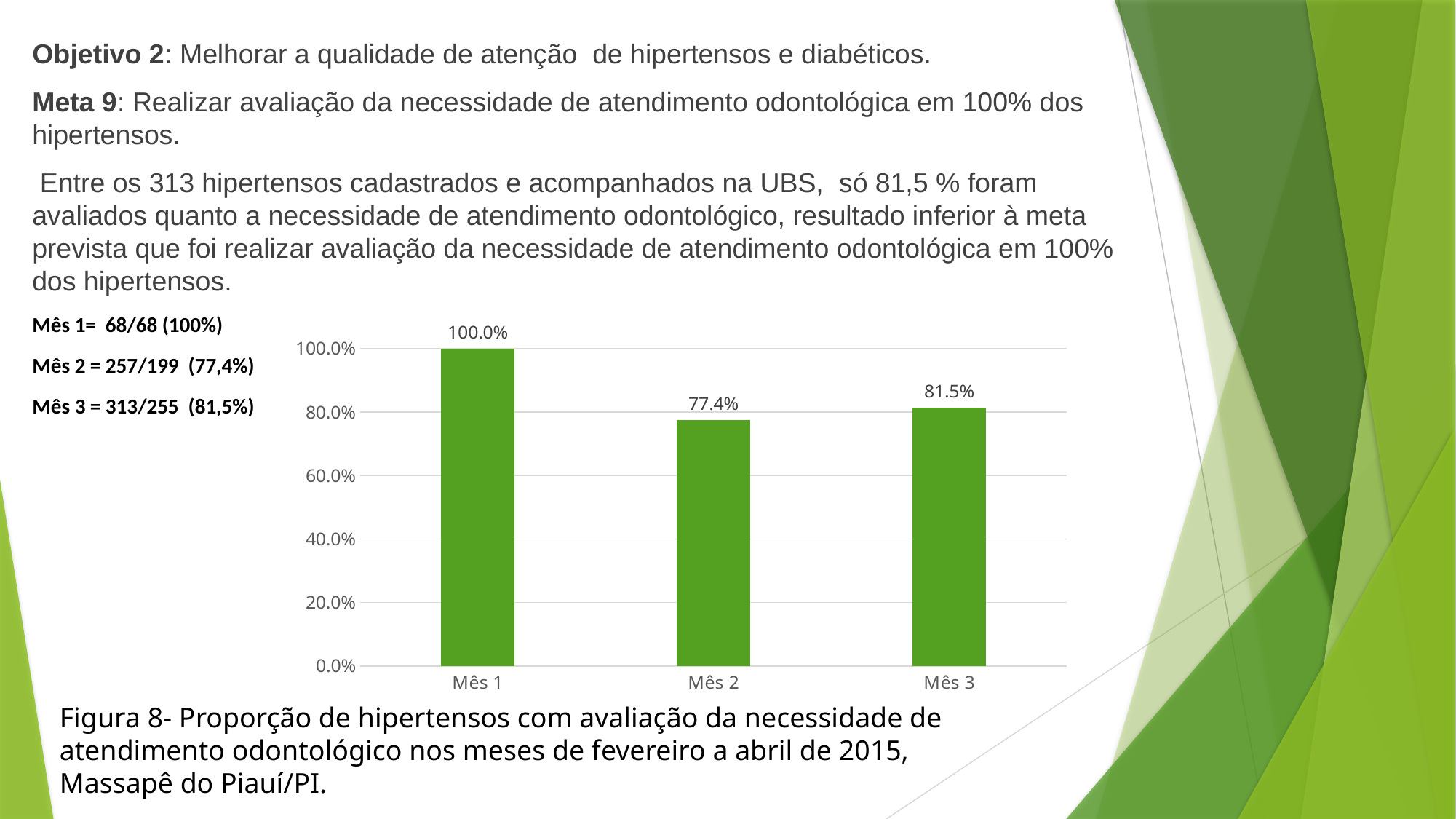
What is the difference between the values for Mês 3 and Mês 2? 4.1% Which month has the lowest value? Mês 2 What is the value for Mês 1? 100.0% What is the difference between the values for Mês 1 and Mês 3? 18.5% What is the value for Mês 2? 77.4% Which is larger, the value for Mês 2 or the value for Mês 3? Mês 3 How many months are shown on the x axis? 3 Is the value for Mês 2 greater or less than 80.0%? less Which month has the highest value? Mês 1 What kind of chart is shown on the slide? bar chart What is the value for Mês 3? 81.5% What colour are the bars in the chart? green